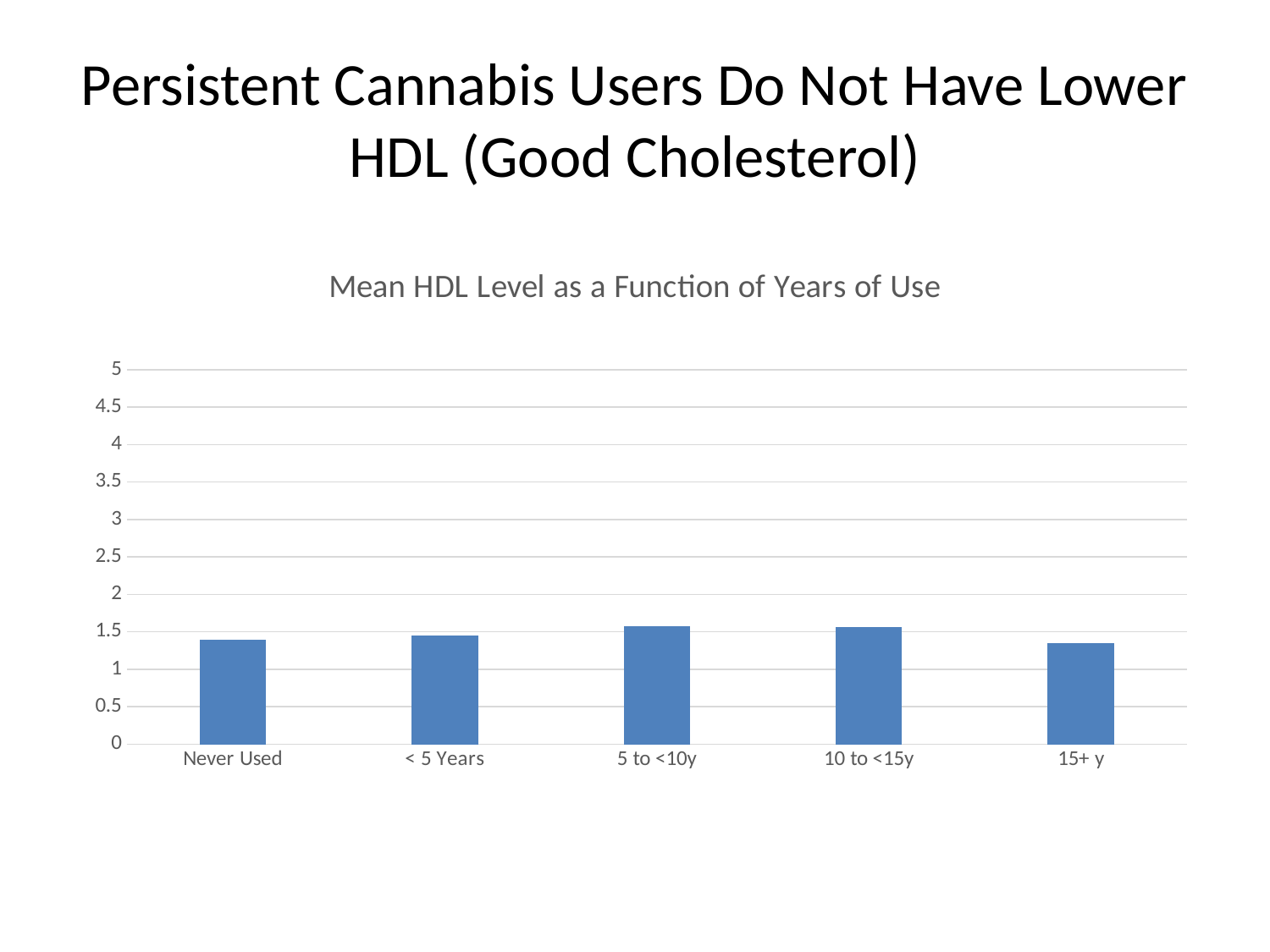
Is the value for Never Used greater or less than 1.5? less What kind of chart is shown on the slide? bar chart What is the highest value shown on the y axis? 5 Is the value for 10 to <15y greater or less than 2? less Is the value for < 5 Years greater or less than 1? greater Which has the larger value, Never Used or 10 to <15y? 10 to <15y Which has the larger value, 5 to <10y or 15+ y? 5 to <10y What is the title of the chart? Mean HDL Level as a Function of Years of Use How many categories of years of use are shown on the x axis? 5